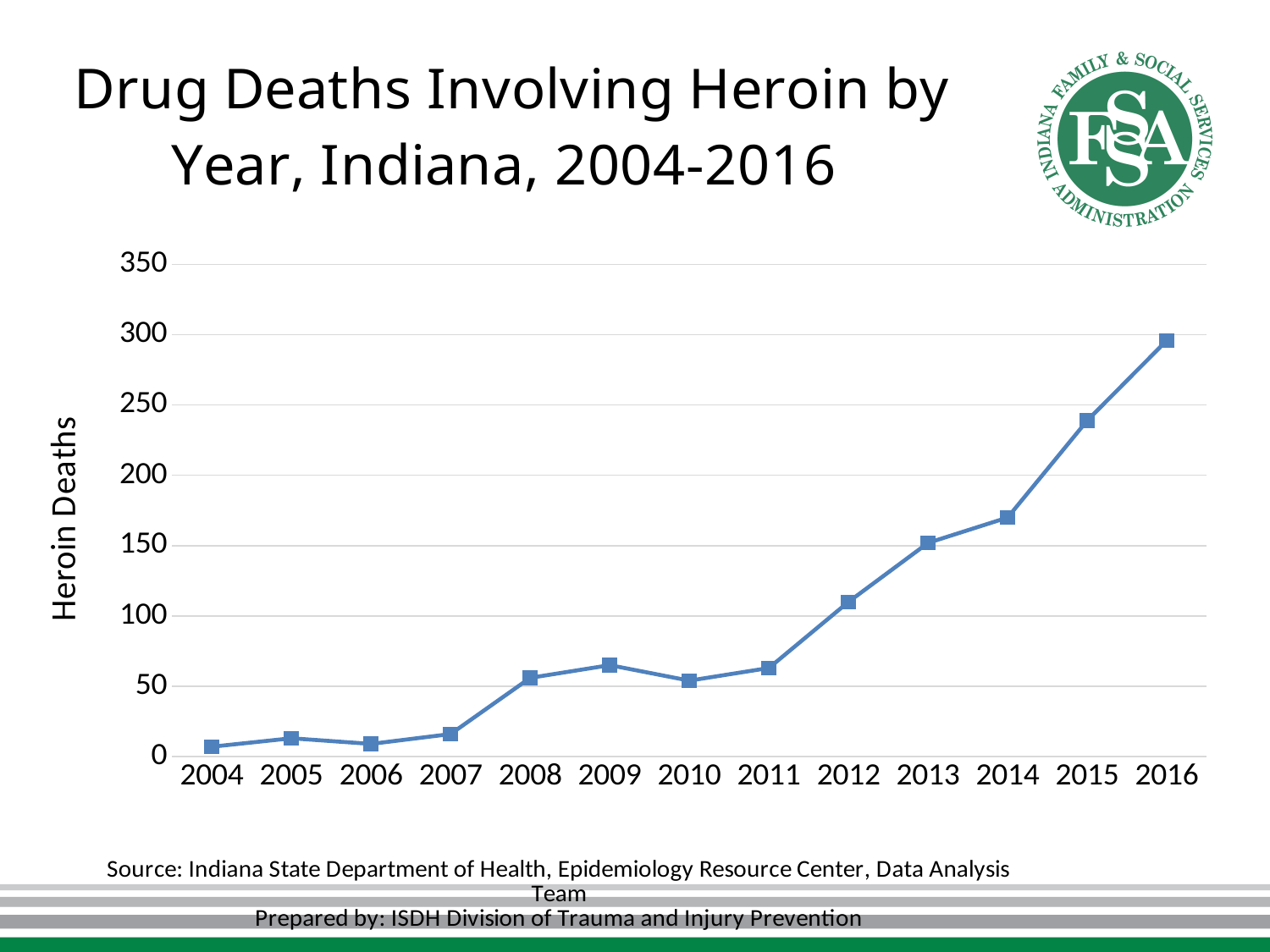
Which year has more heroin deaths, 2012 or 2009? 2012 Is the value for 2004 greater or less than 50? less What is the label on the vertical axis? Heroin Deaths Is the value for 2016 greater or less than 250? greater What kind of chart is shown on the slide? line chart Is the value for 2009 greater or less than 50? greater How many years are plotted on the x axis? 13 Which year has the highest number of heroin deaths? 2016 Which year has more heroin deaths, 2015 or 2014? 2015 Overall, do heroin deaths rise or fall from 2004 to 2016? rise